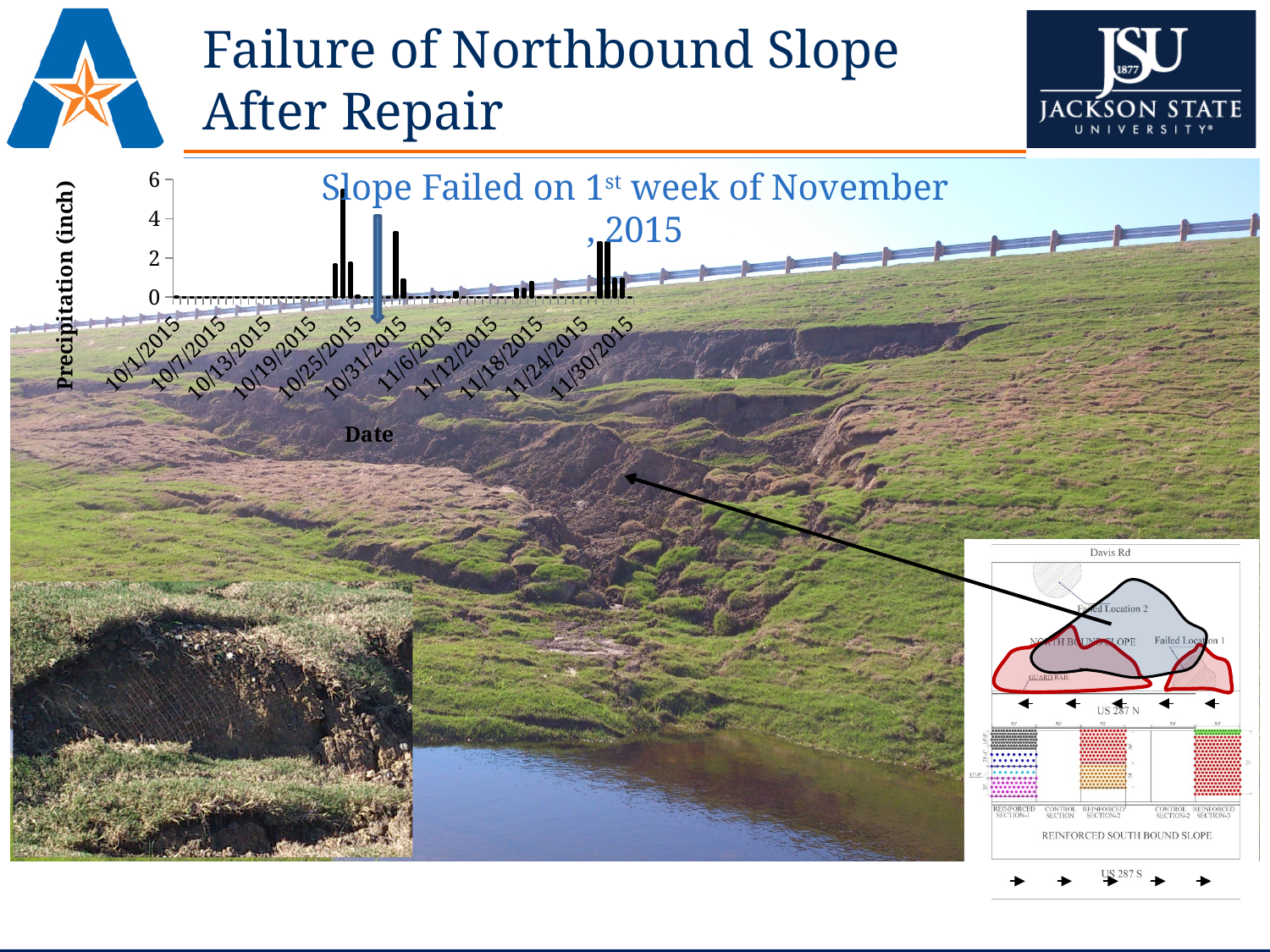
Is the tallest bar in the precipitation chart greater or less than 6? less What is the last date label on the x axis of the precipitation chart? 11/30/2015 What is the first date label on the x axis of the precipitation chart? 10/1/2015 Is the tallest bar in the precipitation chart greater or less than 4? greater What is the title of the horizontal axis of the precipitation chart? Date Are the bars in the precipitation chart vertical or horizontal? vertical What is the title of the vertical axis of the precipitation chart? Precipitation (inch) What is the highest tick value shown on the y axis of the precipitation chart? 6 What kind of chart is the precipitation chart on the slide? bar chart How many date labels are shown along the x axis of the precipitation chart? 11